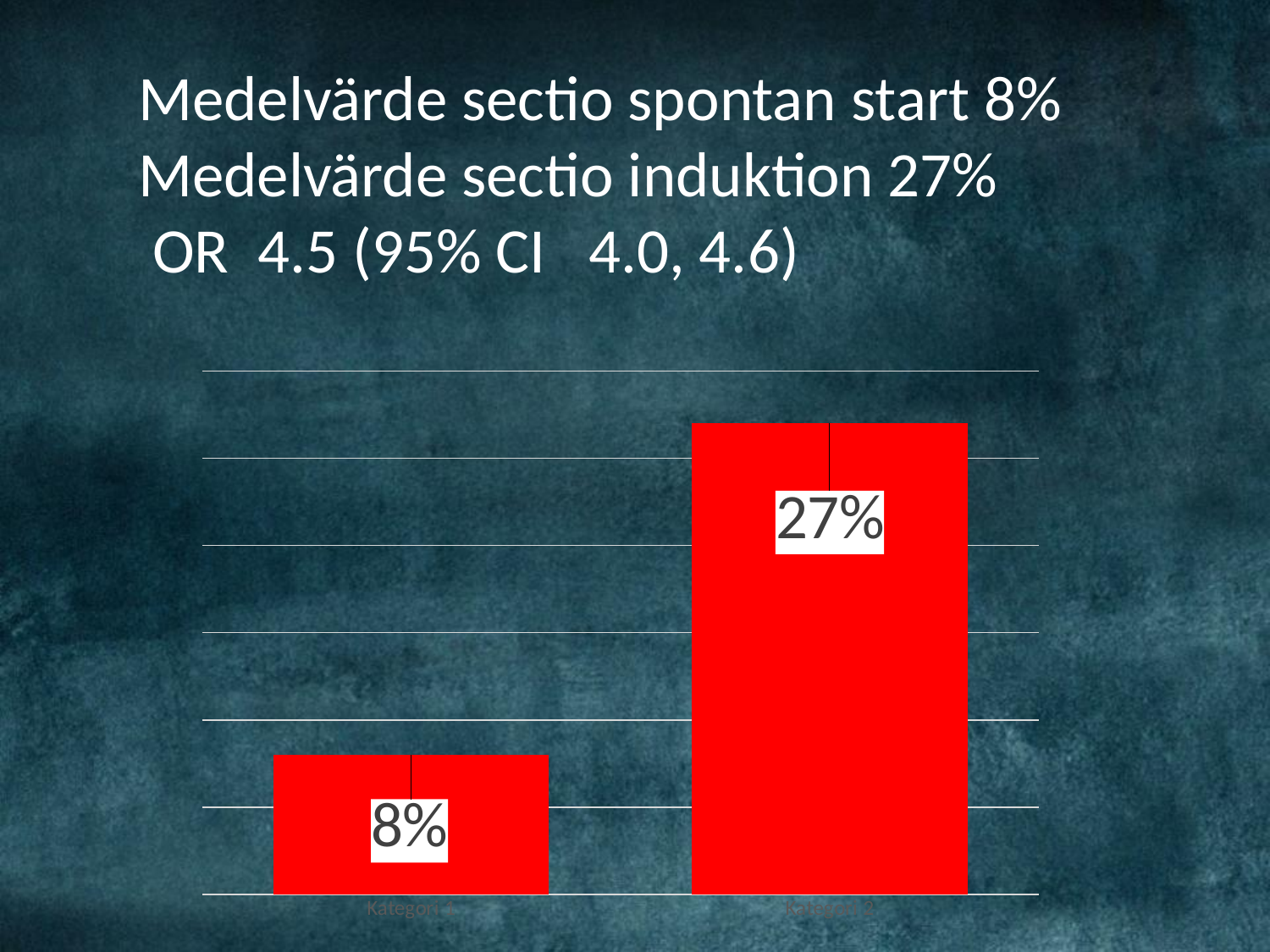
Which is larger, the value for Kategori 1 or the value for Kategori 2? Kategori 2 How many categories are plotted in the chart? 2 What colour are the bars in the chart? Red Which category has the lowest value? Kategori 1 Which category has the highest value? Kategori 2 According to the slide text, what is the mean sectio rate for induktion? 27% What is the value shown for Kategori 2? 27% What is the value shown for Kategori 1? 8% What is the difference between the values for Kategori 2 and Kategori 1? 19% Do the values rise or fall from Kategori 1 to Kategori 2? Rise What kind of chart is shown on the slide? Bar chart